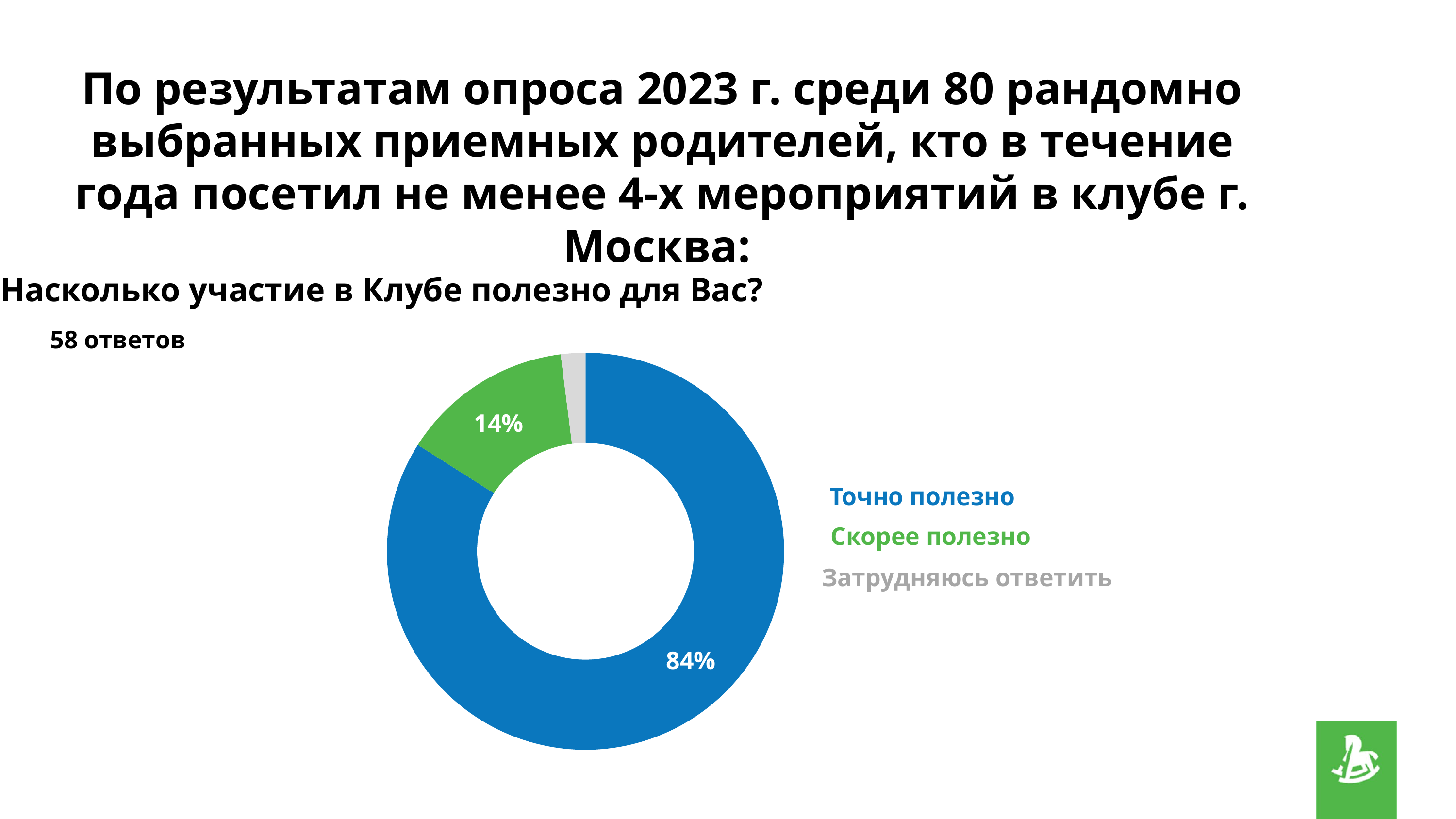
Which answer option has the largest share of the chart? Точно полезно What kind of chart is shown on the slide? Pie (donut) chart What percentage of respondents answered "Точно полезно"? 84% How many entries does the legend list? 3 Which is larger: the share for "Точно полезно" or the share for "Скорее полезно"? Точно полезно What percentage of respondents answered "Скорее полезно"? 14% Which answer option has the smallest share of the chart? Затрудняюсь ответить By how many percentage points does "Точно полезно" exceed "Скорее полезно"? 70 percentage points What colour is the "Точно полезно" slice? Blue How many answer options (slices) does the chart show? 3 How many responses does the chart say it is based on? 58 ответов What share of the pie does the "Скорее полезно" slice take? 14%